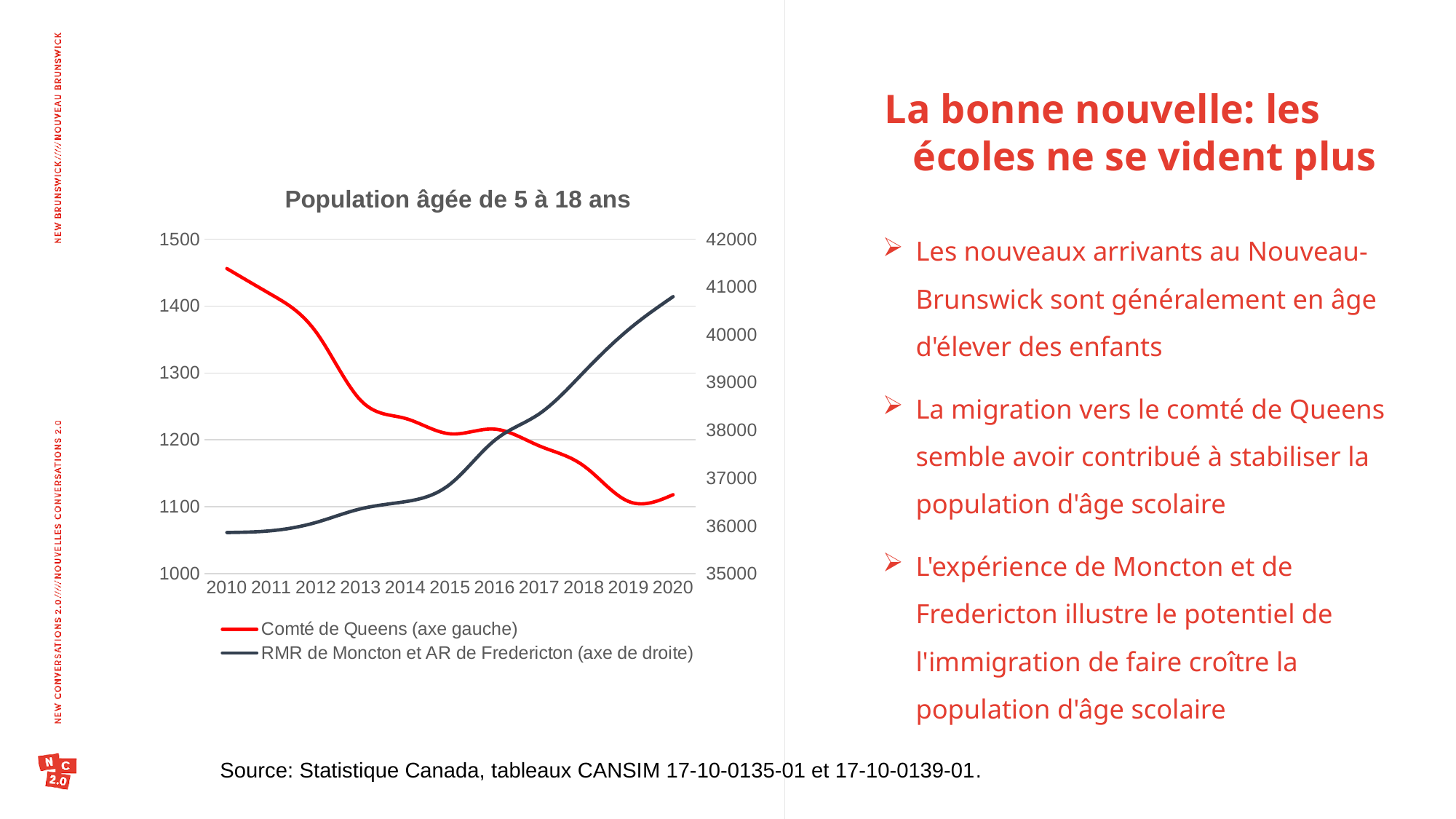
How many series does the legend list? 2 Is the Comté de Queens value for 2010 greater or less than 1400? greater How many years are plotted along the x axis? 11 What kind of chart is shown on the slide? line chart Is the RMR de Moncton et AR de Fredericton value for 2014 greater or less than 37000? less Is the Comté de Queens value for 2019 greater or less than 1200? less Does the Comté de Queens line rise or fall overall from 2010 to 2020? fall Does the RMR de Moncton et AR de Fredericton line rise or fall overall from 2010 to 2020? rise What is the title of the chart? Population âgée de 5 à 18 ans In which year is the Comté de Queens series at its highest? 2010 Which series is plotted on the right-hand axis according to the legend? RMR de Moncton et AR de Fredericton